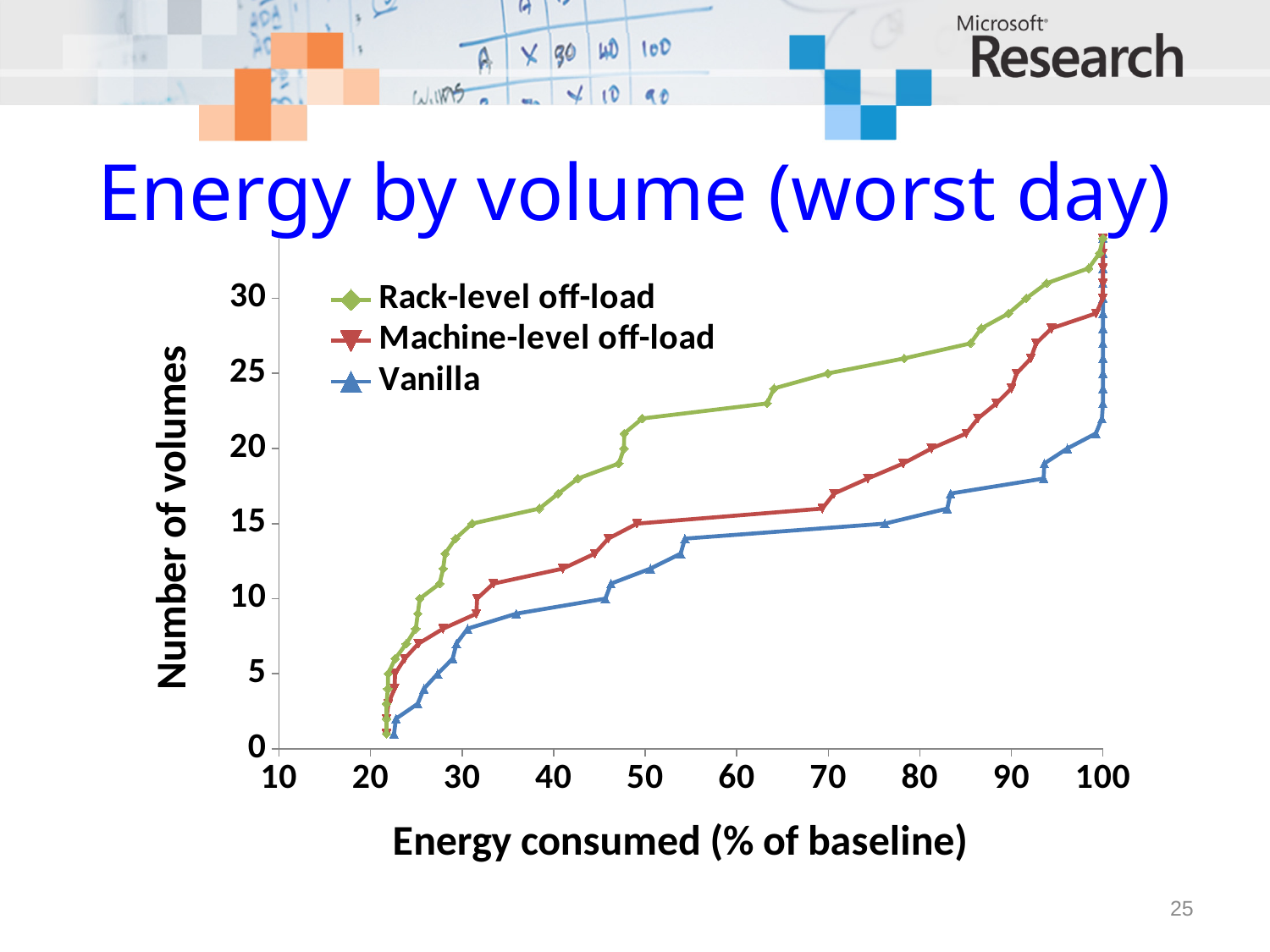
Which series reaches 30 volumes at the lowest energy consumed? Rack-level off-load Is the energy consumed for the Vanilla series at 15 volumes greater or less than 70? greater What is the label of the x axis? Energy consumed (% of baseline) How many series does the legend list? 3 Is the energy consumed for the Vanilla series at 20 volumes greater or less than 90? greater What kind of chart is shown on the slide? line chart Is the energy consumed for the Rack-level off-load series at 20 volumes greater or less than 50? less At 15 volumes, which series consumes more energy, Vanilla or Rack-level off-load? Vanilla Does the number of volumes rise or fall as energy consumed increases along the x axis? rise What is the title of the chart? Energy by volume (worst day)